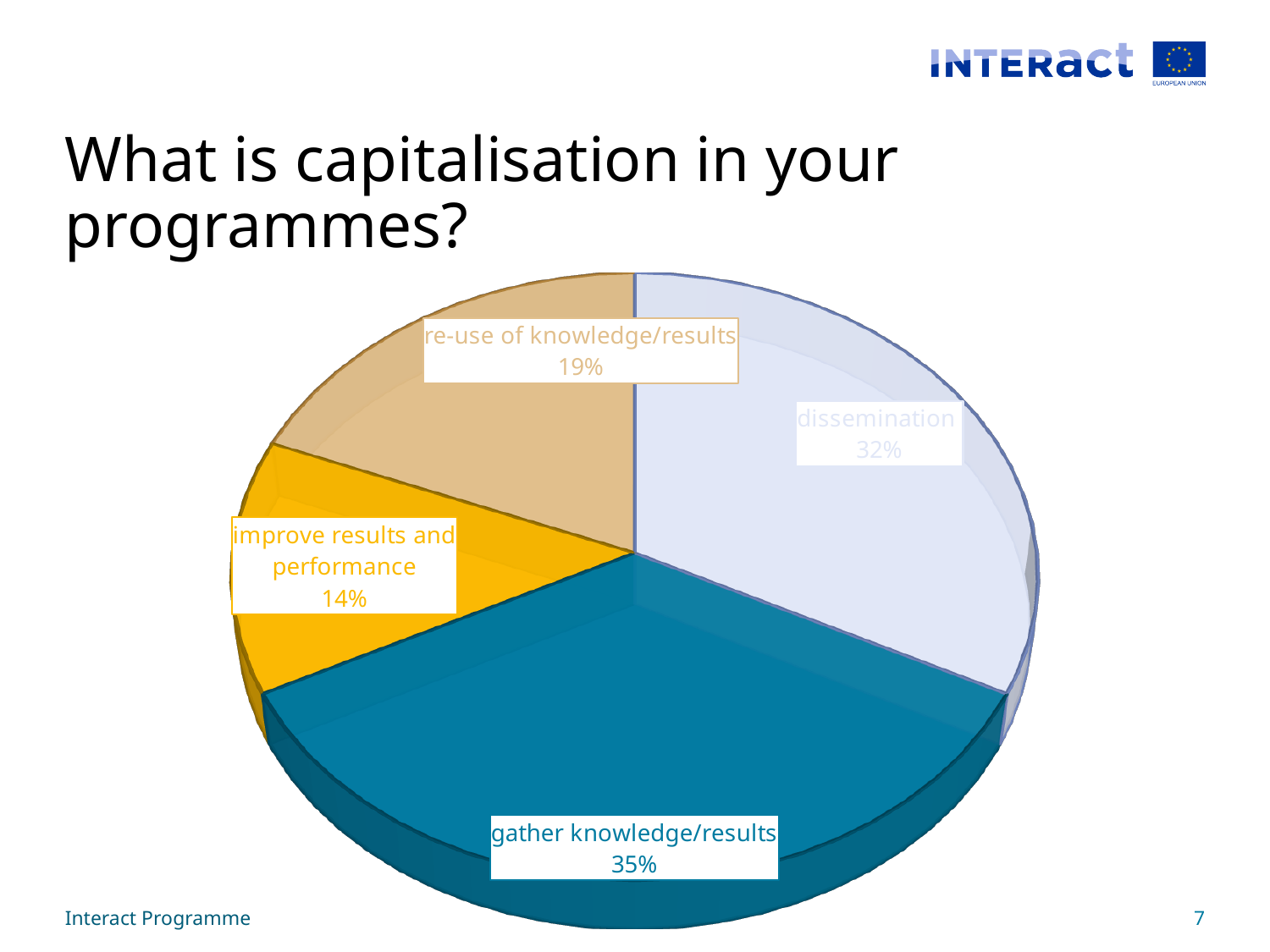
What is the difference in percentage points between "dissemination" and "re-use of knowledge/results"? 13 What kind of chart is shown on the slide? pie chart Which category has the largest slice of the pie? gather knowledge/results Which is larger, the share for "re-use of knowledge/results" or the share for "improve results and performance"? re-use of knowledge/results Which category has the smallest slice of the pie? improve results and performance What is the title of the slide containing the pie chart? What is capitalisation in your programmes? What share of the pie does "gather knowledge/results" have? 35% What share of the pie does "dissemination" have? 32% What share of the pie does "improve results and performance" have? 14% How many slices does the pie chart have? 4 What is the difference in percentage points between "gather knowledge/results" and "improve results and performance"? 21